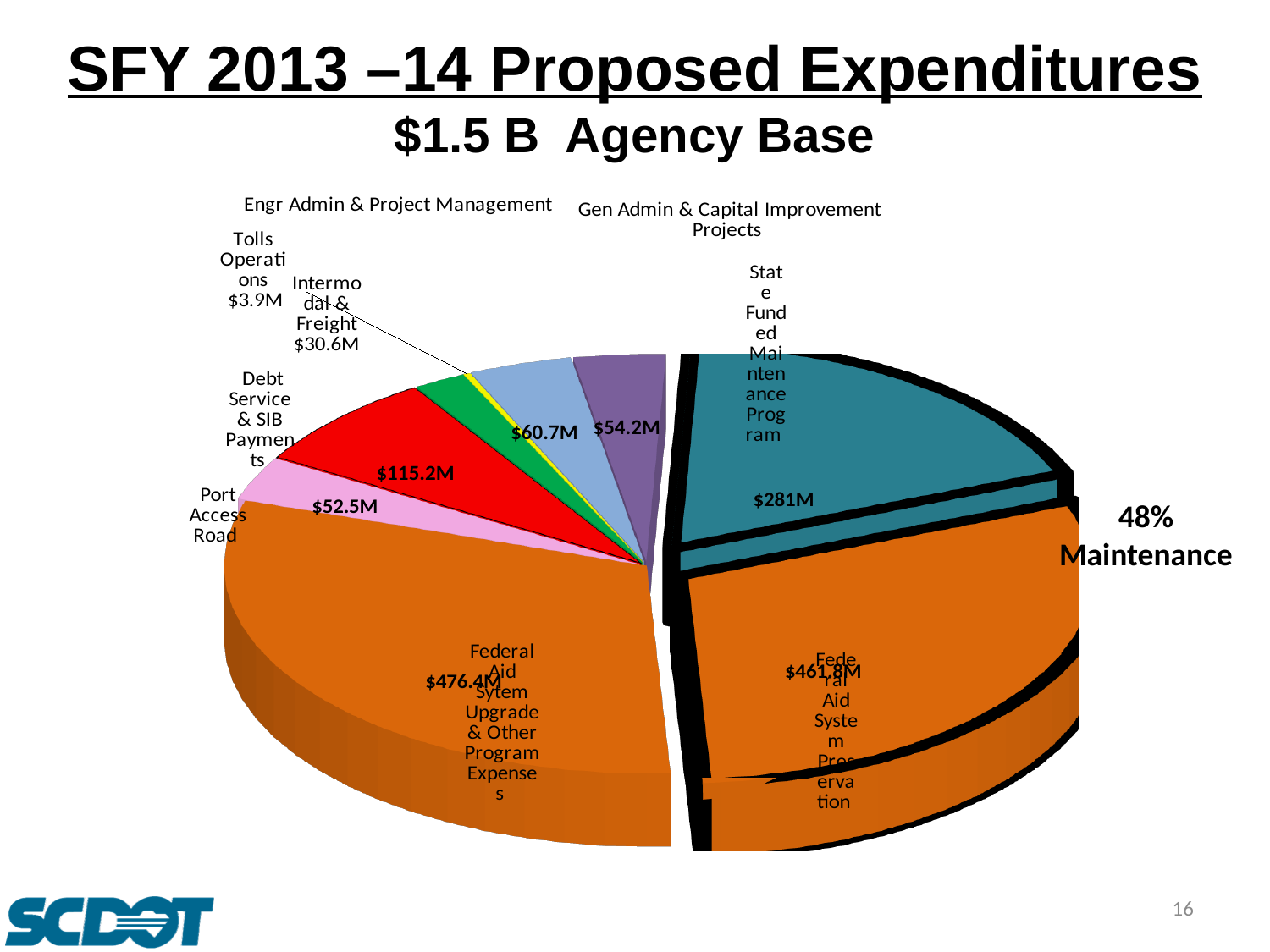
What is the value for the State Funded Maintenance Program slice? $281M What is the value for Federal Aid System Upgrade & Other Program Expenses? $476.4M Which category has the smallest slice of the pie? Tolls Operations What is the value for Federal Aid System Preservation? $461.8M What is the value for Tolls Operations? $3.9M What is the value for Intermodal & Freight? $30.6M What is the value for Debt Service & SIB Payments? $115.2M Which is larger, Port Access Road or Debt Service & SIB Payments? Debt Service & SIB Payments What percentage of the pie is labelled as Maintenance on the slide? 48% What kind of chart is shown on the slide? Pie chart Which category has the largest slice of the pie? Federal Aid System Upgrade & Other Program Expenses What is the difference between the State Funded Maintenance Program and Debt Service & SIB Payments values? $165.8M